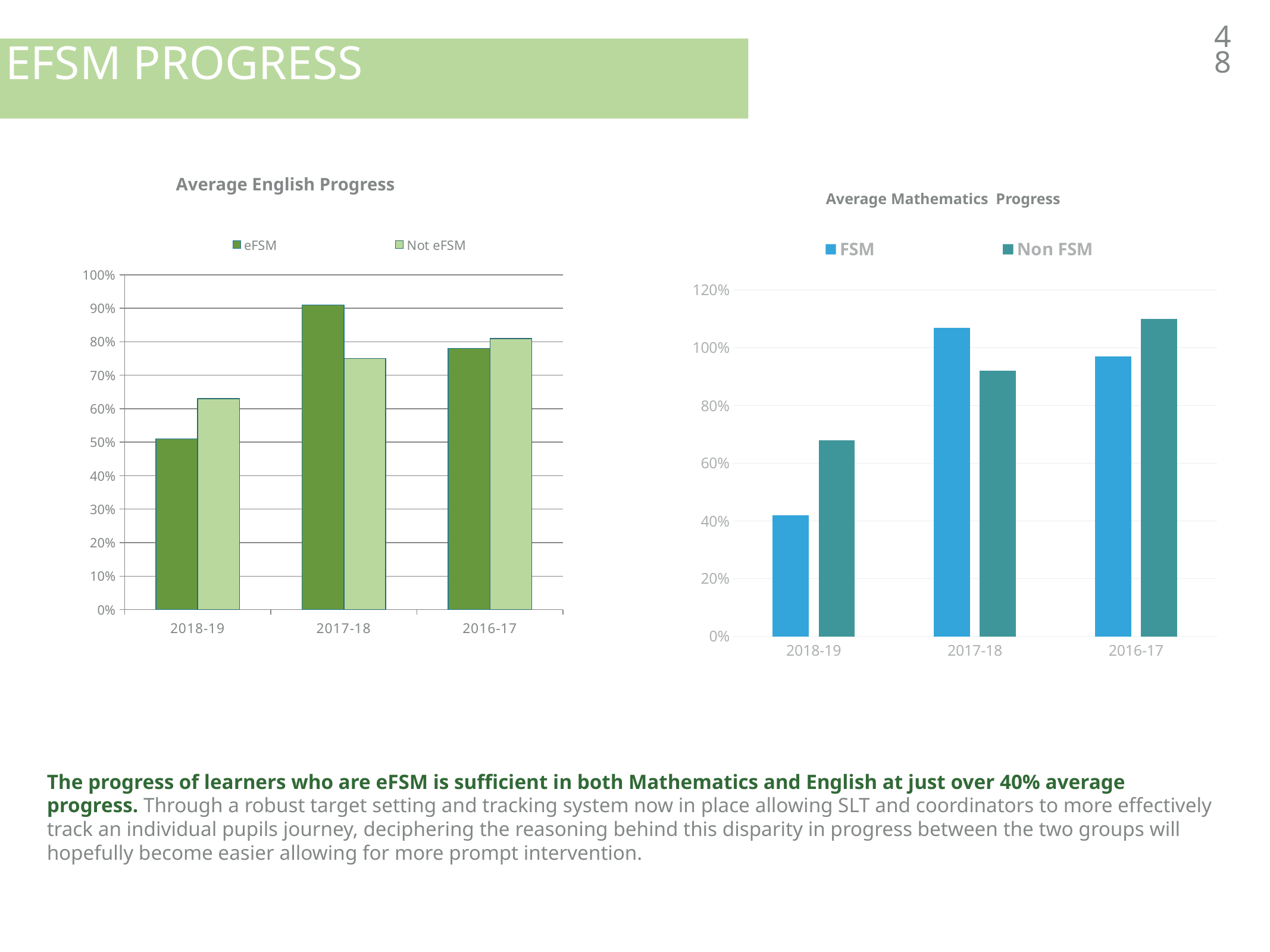
In the Average Mathematics Progress chart, is the FSM value for 2017-18 greater or less than 100%? greater In the Average Mathematics Progress chart, which is larger for 2017-18: FSM or Non FSM? FSM How many year categories are shown on the x axis of the Average Mathematics Progress chart? 3 In the Average Mathematics Progress chart, which year has the lowest FSM value? 2018-19 How many series does the legend of the Average English Progress chart list? 2 What kind of chart is the Average English Progress chart? bar chart What are the two legend entries in the Average Mathematics Progress chart? FSM and Non FSM In the Average English Progress chart, is the eFSM value for 2018-19 greater or less than 60%? less In the Average Mathematics Progress chart, which year has the highest Non FSM value? 2016-17 In the Average English Progress chart, which year has the lowest Not eFSM value? 2018-19 In the Average English Progress chart, which is larger for 2018-19: eFSM or Not eFSM? Not eFSM In the Average English Progress chart, which year has the highest eFSM value? 2017-18